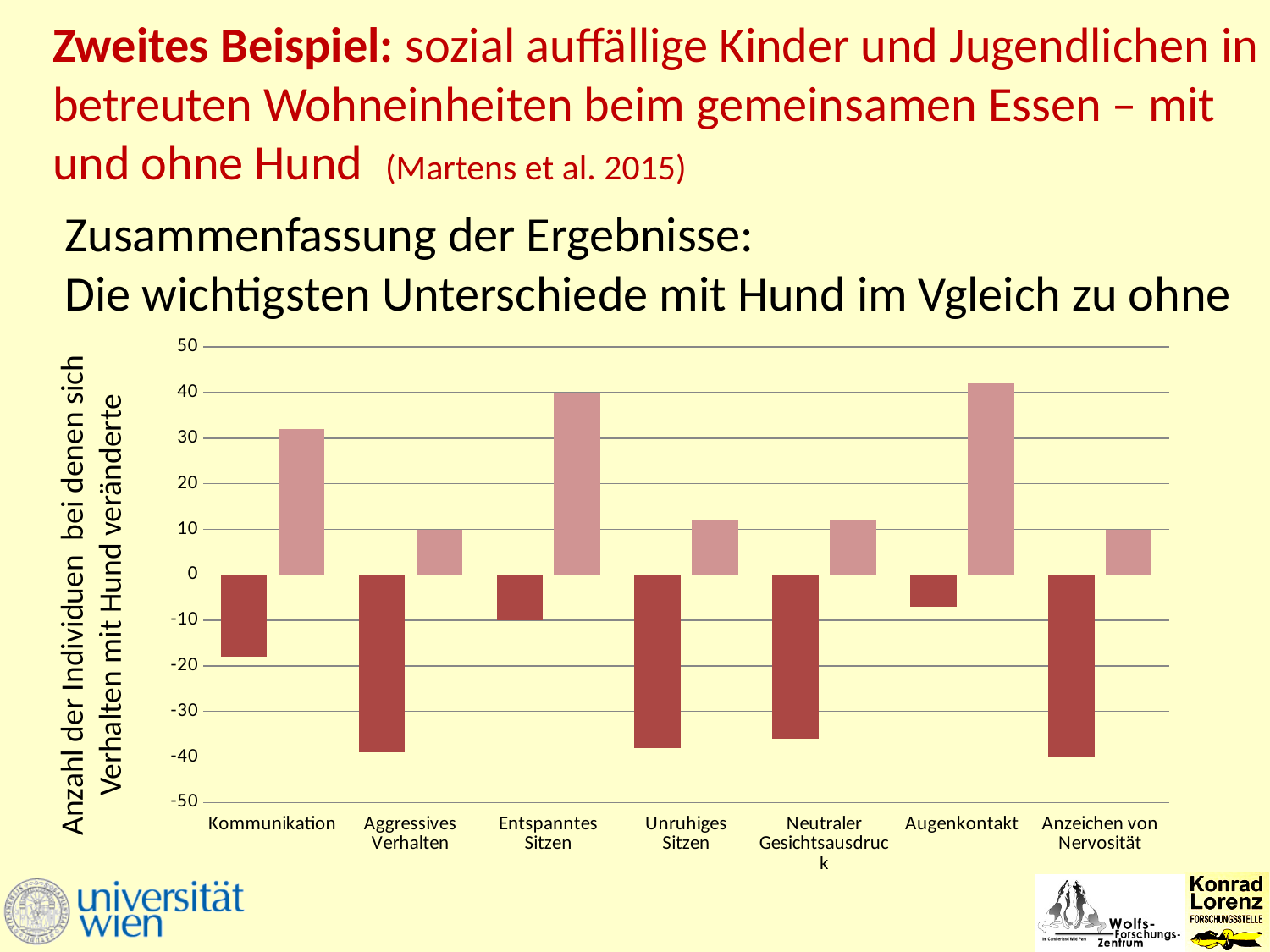
Is the value of the dark red bar for Unruhiges Sitzen greater or less than -30? less Is the value of the light pink bar for Augenkontakt greater or less than 30? greater How many bars are shown for each category in the chart? 2 Which has the more negative dark red bar, Kommunikation or Augenkontakt? Kommunikation What is the value of the light pink bar for Anzeichen von Nervosität? 10 What is the value of the light pink bar for Aggressives Verhalten? 10 What is the value of the light pink bar for Entspanntes Sitzen? 40 Is the value of the dark red bar for Kommunikation greater or less than -10? less What kind of chart is shown on the slide? bar chart How many categories are shown on the x axis of the chart? 7 Which has the larger light pink bar, Kommunikation or Aggressives Verhalten? Kommunikation